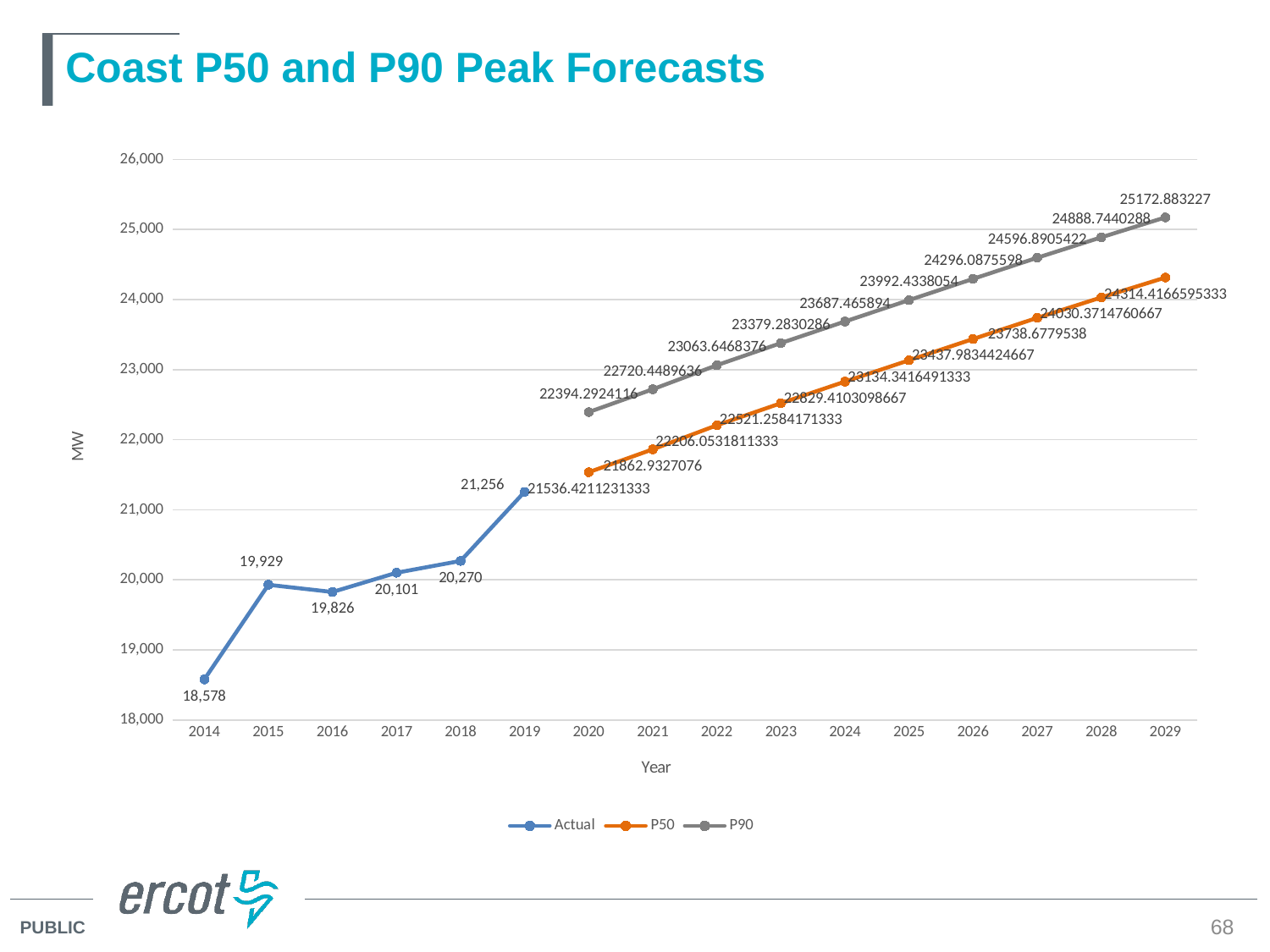
How many series does the legend list? 3 What is the difference between the Actual values for 2015 and 2014? 1,351 What is the Actual value for 2019? 21,256 What type of chart is shown on the slide? Line chart Which is larger in 2029, the P50 value or the P90 value? P90 Does the P90 series rise or fall from 2020 to 2029? Rise What is the P90 value for 2020? 22394.2924116 Which year has the lowest Actual value? 2014 Is the P90 value for 2023 greater or less than 23,000? greater Which year has the highest Actual value? 2019 What is the Actual value for 2014? 18,578 What is the P90 value for 2029? 25172.883227